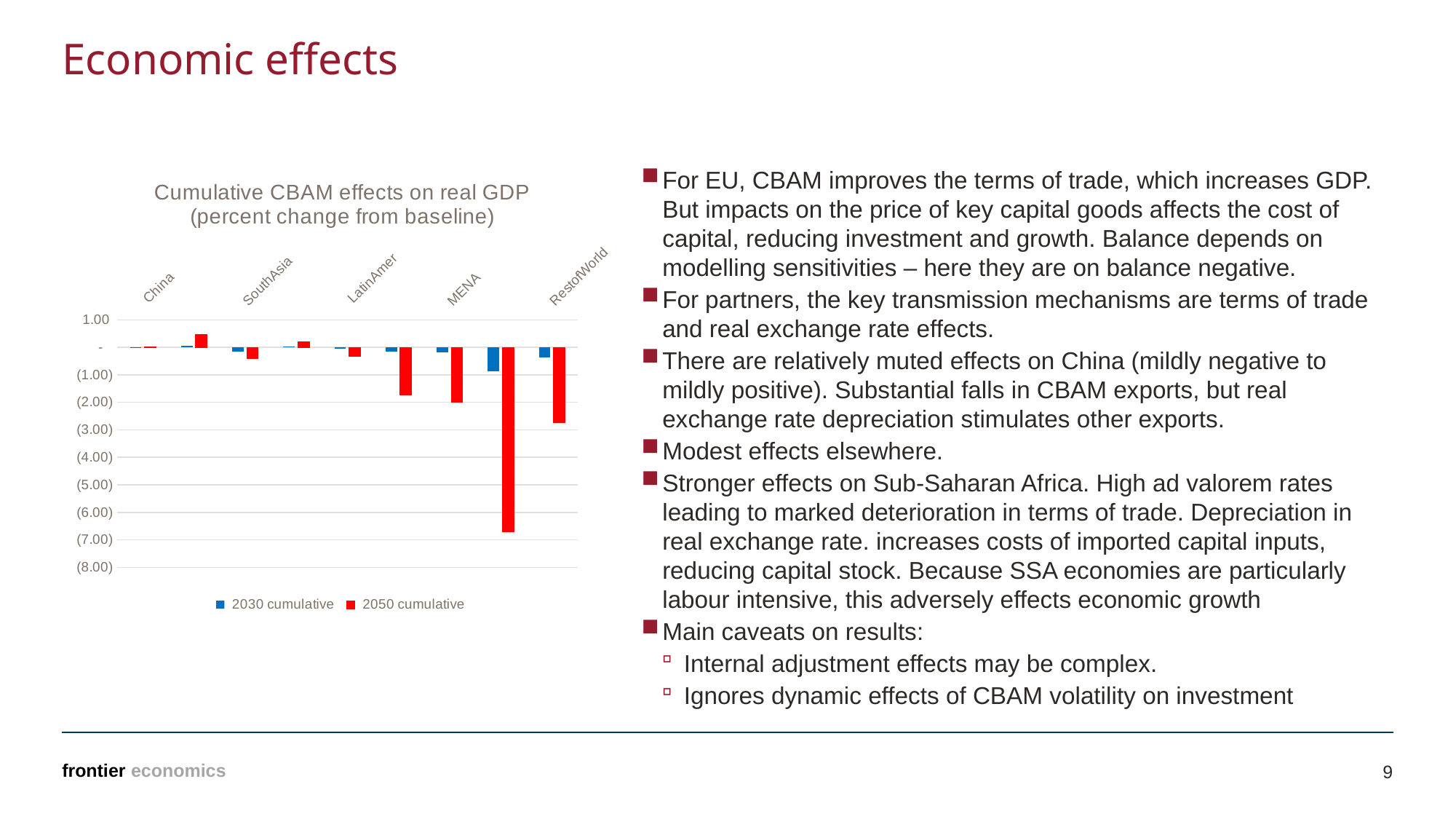
Is the 2050 cumulative value for MENA greater or less than (1.00)? less Which colour represents the 2050 cumulative series in the chart? red For RestofWorld, which series has the lower (more negative) value, 2030 cumulative or 2050 cumulative? 2050 cumulative How many series does the legend of the chart list? 2 Is the 2030 cumulative value for MENA greater or less than (1.00)? greater Which has the higher 2050 cumulative value, SouthAsia or MENA? SouthAsia What is the title of the chart? Cumulative CBAM effects on real GDP (percent change from baseline) Which has the lower 2050 cumulative value, MENA or RestofWorld? RestofWorld Is the 2050 cumulative value for LatinAmer greater or less than (1.00)? greater What type of chart is shown on the slide? bar chart